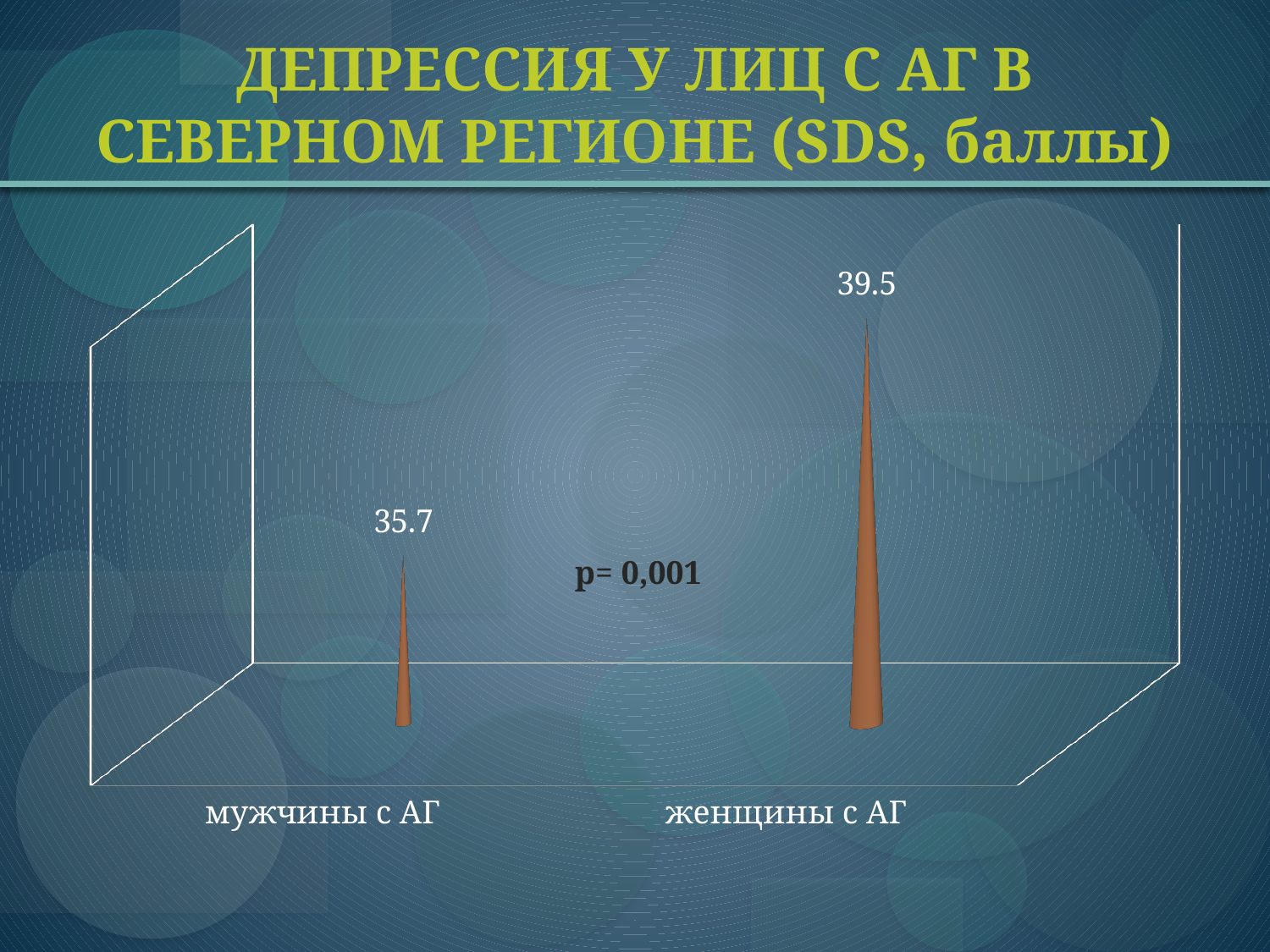
What is the difference between the values for женщины с АГ and мужчины с АГ? 3.8 Which is larger, the value for мужчины с АГ or the value for женщины с АГ? женщины с АГ What kind of chart is shown on the slide? bar chart Which category has the lowest value? мужчины с АГ What is the value for мужчины с АГ? 35.7 What is the value for женщины с АГ? 39.5 Which category has the highest value? женщины с АГ How many categories are shown in the chart? 2 What p-value is printed on the chart? p= 0,001 What is the title of the chart? ДЕПРЕССИЯ У ЛИЦ С АГ В СЕВЕРНОМ РЕГИОНЕ (SDS, баллы)